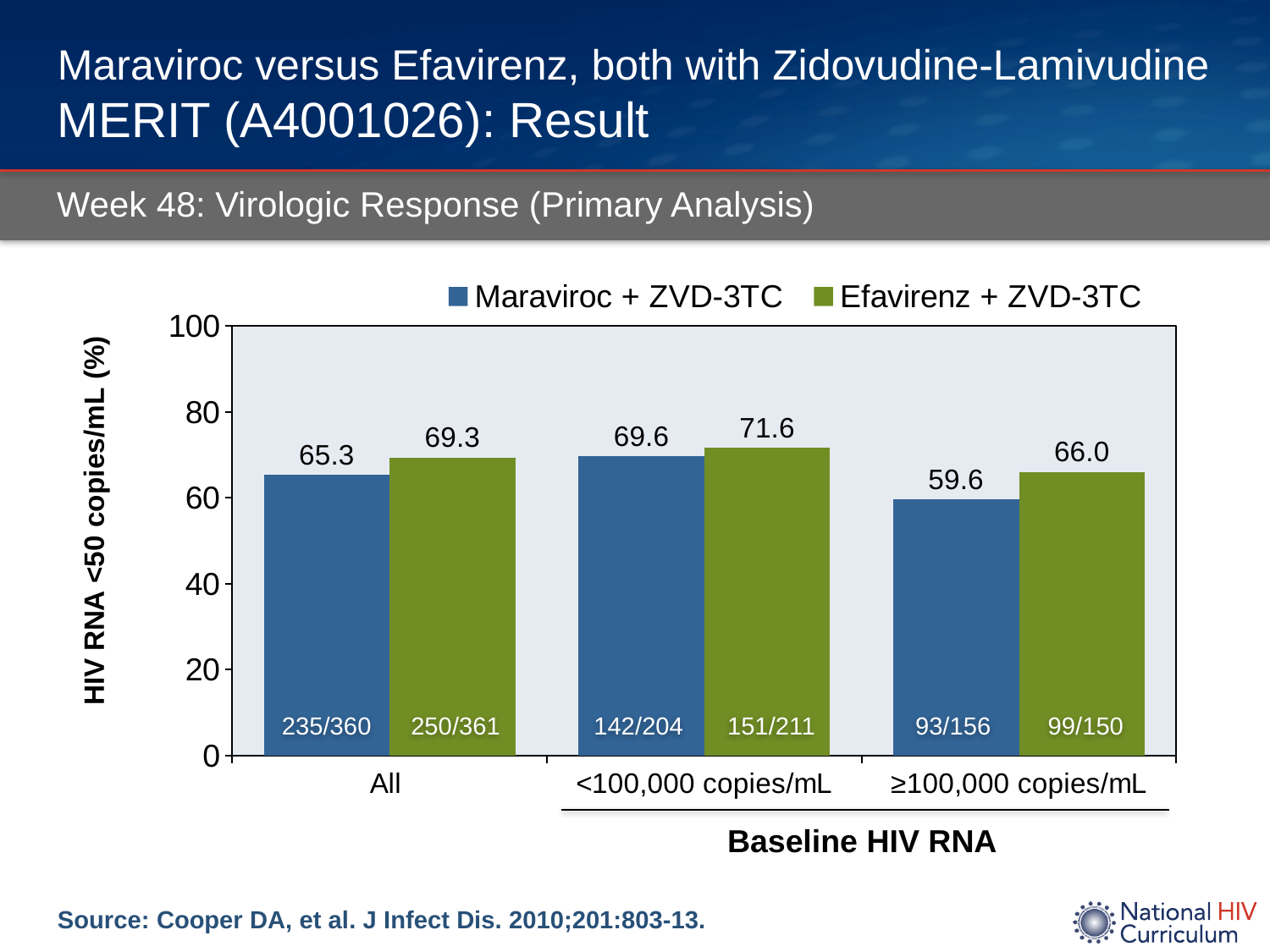
What is the value for Maraviroc + ZVD-3TC in the All category? 65.3 How many categories are shown on the x axis? 3 What kind of chart is shown on the slide? bar chart What is the difference between the Efavirenz + ZVD-3TC and Maraviroc + ZVD-3TC values in the ≥100,000 copies/mL category? 6.4 In the All category, which series has the larger value, Maraviroc + ZVD-3TC or Efavirenz + ZVD-3TC? Efavirenz + ZVD-3TC Which category has the highest value for Efavirenz + ZVD-3TC? <100,000 copies/mL What is the value for Efavirenz + ZVD-3TC in the <100,000 copies/mL category? 71.6 What is the value for Efavirenz + ZVD-3TC in the ≥100,000 copies/mL category? 66.0 What is the difference between the Efavirenz + ZVD-3TC and Maraviroc + ZVD-3TC values in the All category? 4.0 Is the value for Maraviroc + ZVD-3TC in the ≥100,000 copies/mL category greater or less than 60? less Which category has the lowest value for Maraviroc + ZVD-3TC? ≥100,000 copies/mL How many series does the legend list? 2